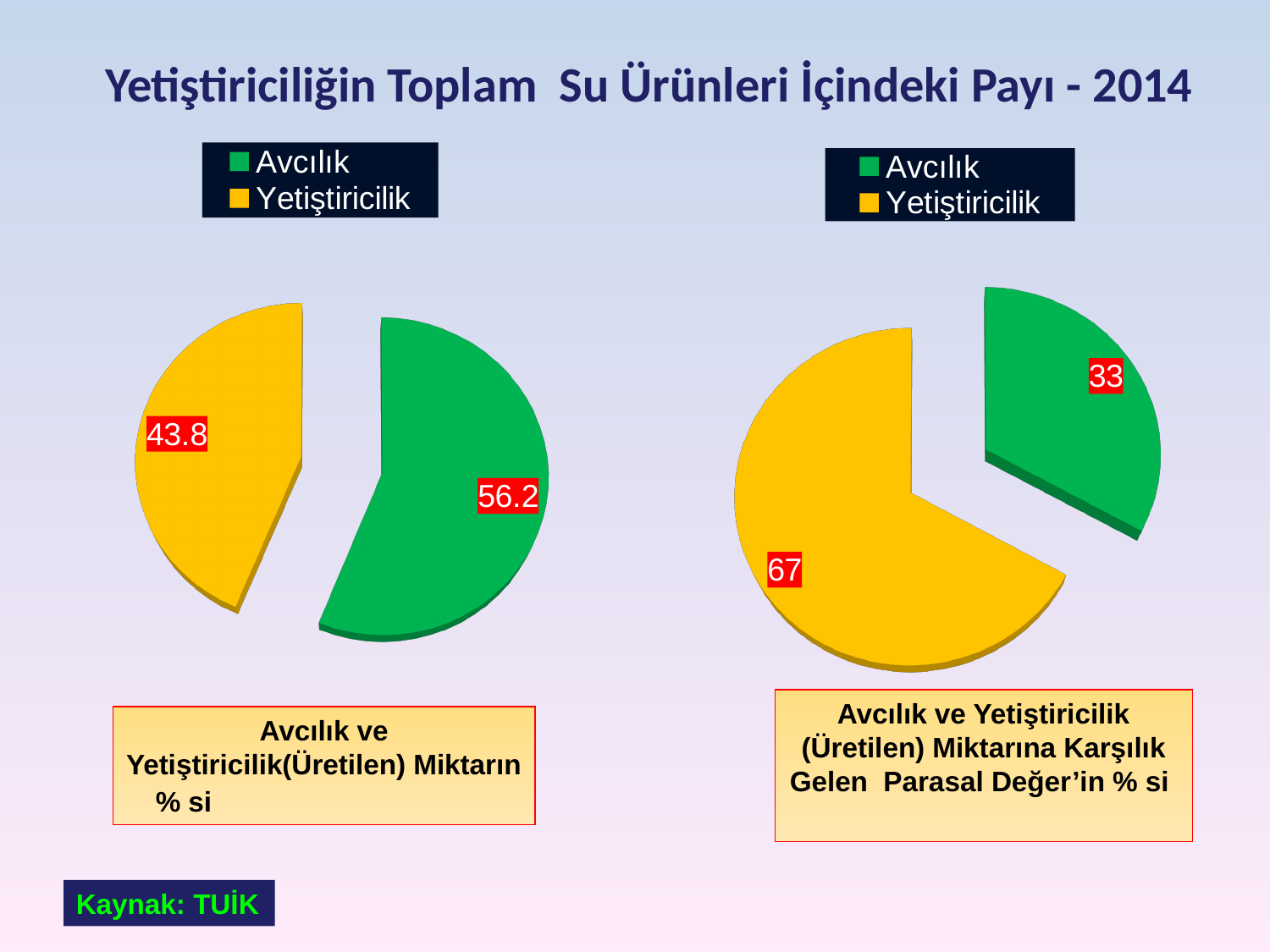
In the right pie chart, which is larger, Avcılık or Yetiştiricilik? Yetiştiricilik In the left pie chart, which category has the largest slice? Avcılık In the right pie chart, what is the value for Yetiştiricilik? 67 What type of chart is shown on the right side of the slide? Pie chart In the left pie chart, what is the difference between the Avcılık and Yetiştiricilik values? 12.4 In the right pie chart, what is the difference between the Yetiştiricilik and Avcılık values? 34 In the left pie chart, what is the value for Avcılık? 56.2 How many slices does the left pie chart have? 2 What colour is the Yetiştiricilik slice in the left pie chart? Yellow In the left pie chart, what is the value for Yetiştiricilik? 43.8 In the right pie chart, what is the value for Avcılık? 33 In the right pie chart, which category has the smallest slice? Avcılık